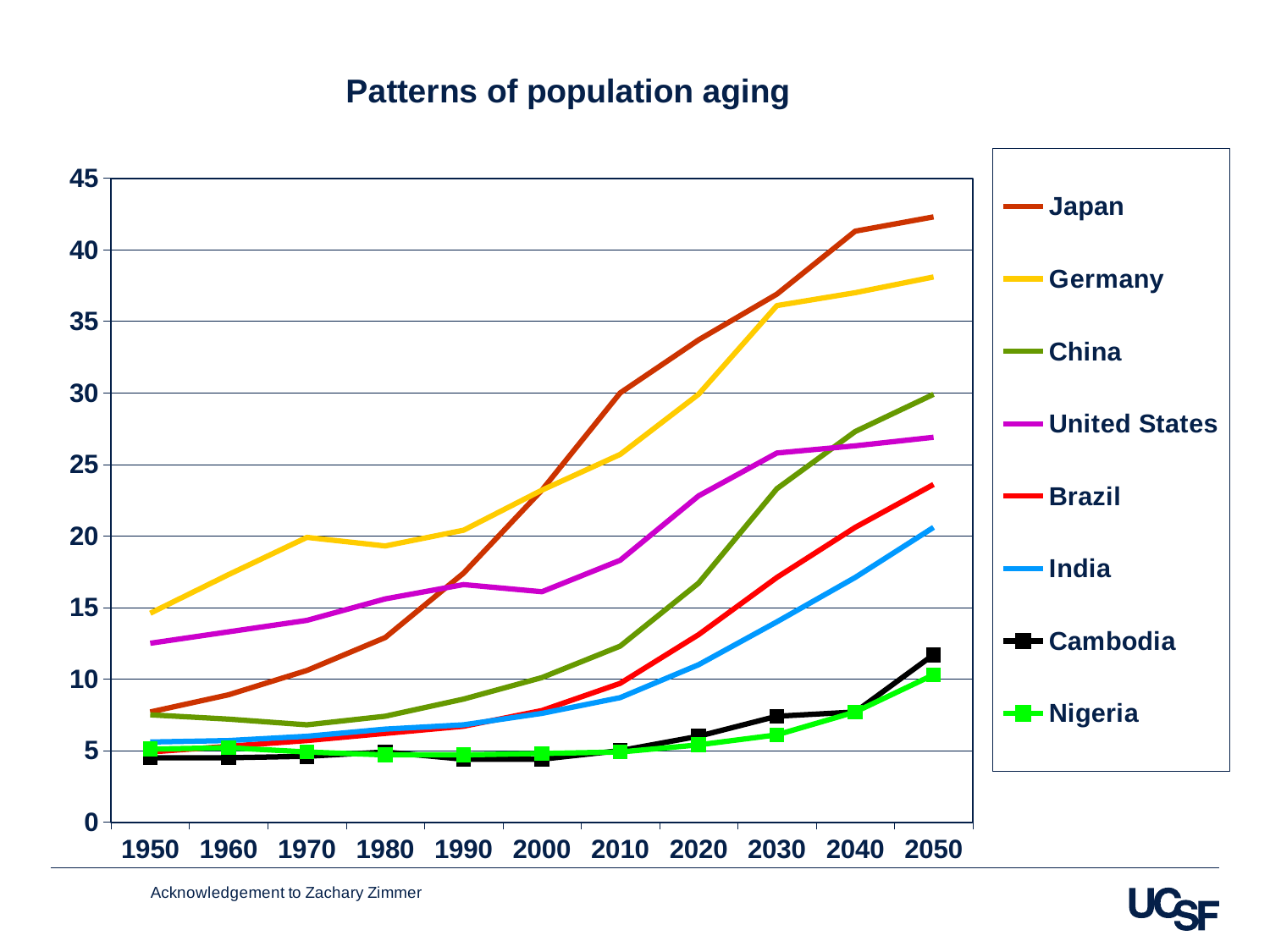
How many series does the legend list? 8 Which country has the highest value in 1950? Germany How many years are marked along the x axis? 11 What is the title of the chart? Patterns of population aging Does the value for Japan rise or fall from 1950 to 2050? rise Is the value for Japan in 1950 greater or less than 10? less Is the value for Japan in 2050 greater or less than 40? greater Which country has the lowest value in 2050? Nigeria What kind of chart is shown on the slide? line chart In 2050, which is larger, the value for China or the value for the United States? China In 2030, which is larger, the value for the United States or the value for China? United States Which country has the highest value in 2050? Japan